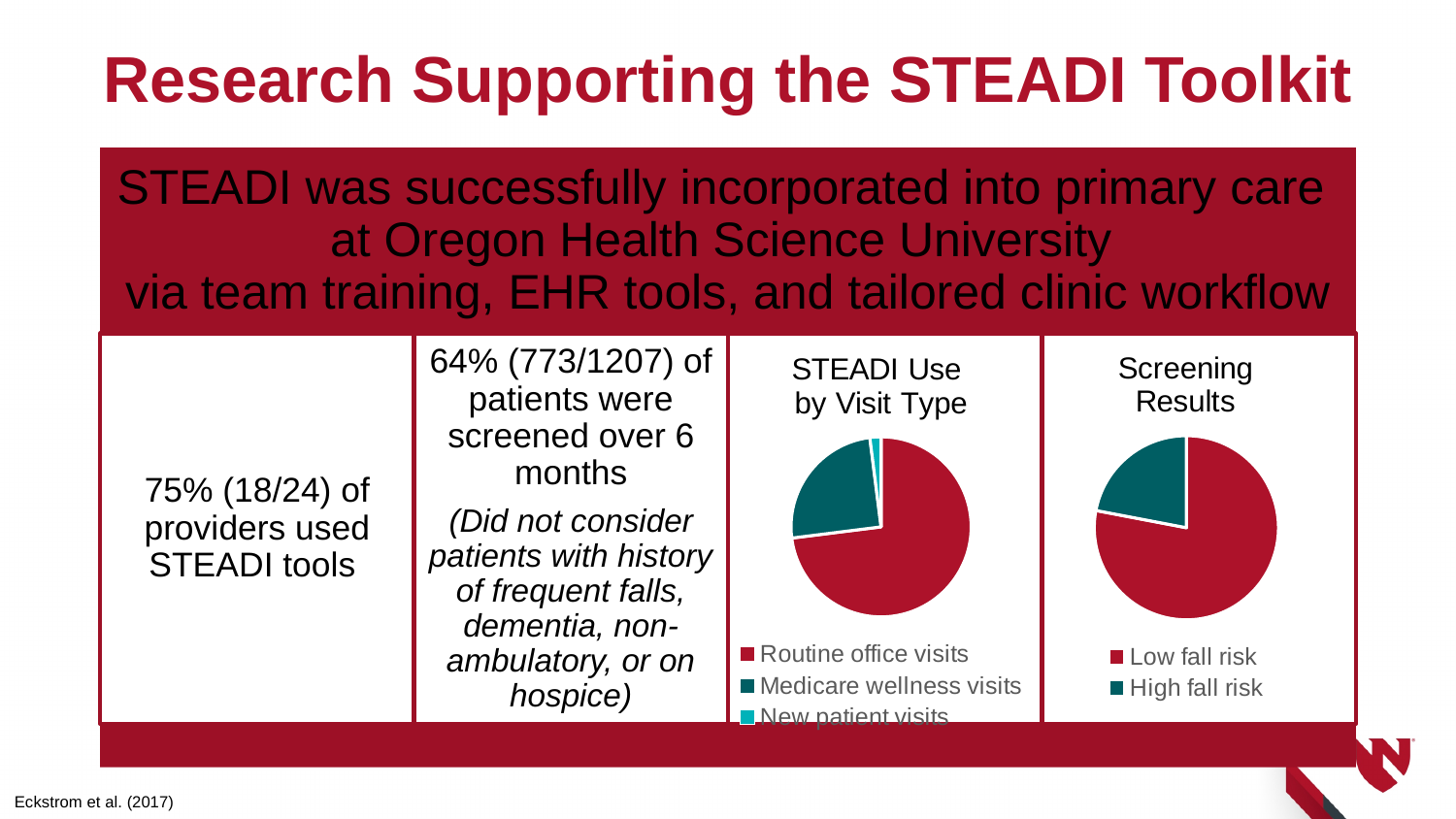
In the "STEADI Use by Visit Type" chart, which visit type has the smallest slice? New patient visits In the "STEADI Use by Visit Type" chart, which slice is larger: Medicare wellness visits or New patient visits? Medicare wellness visits What is the title of the pie chart on the right side of the slide? Screening Results In the "Screening Results" chart, which category has the smaller slice? High fall risk In the "STEADI Use by Visit Type" chart, how many categories does the legend list? 3 What kind of chart is the "STEADI Use by Visit Type" chart? Pie chart In the "Screening Results" chart, which category has the larger slice? Low fall risk In the "Screening Results" chart, which slice is larger: High fall risk or Low fall risk? Low fall risk In the "Screening Results" chart, how many categories does the legend list? 2 In the "STEADI Use by Visit Type" chart, what colour represents Medicare wellness visits? Teal What kind of chart is the "Screening Results" chart? Pie chart In the "STEADI Use by Visit Type" chart, which visit type has the largest slice? Routine office visits